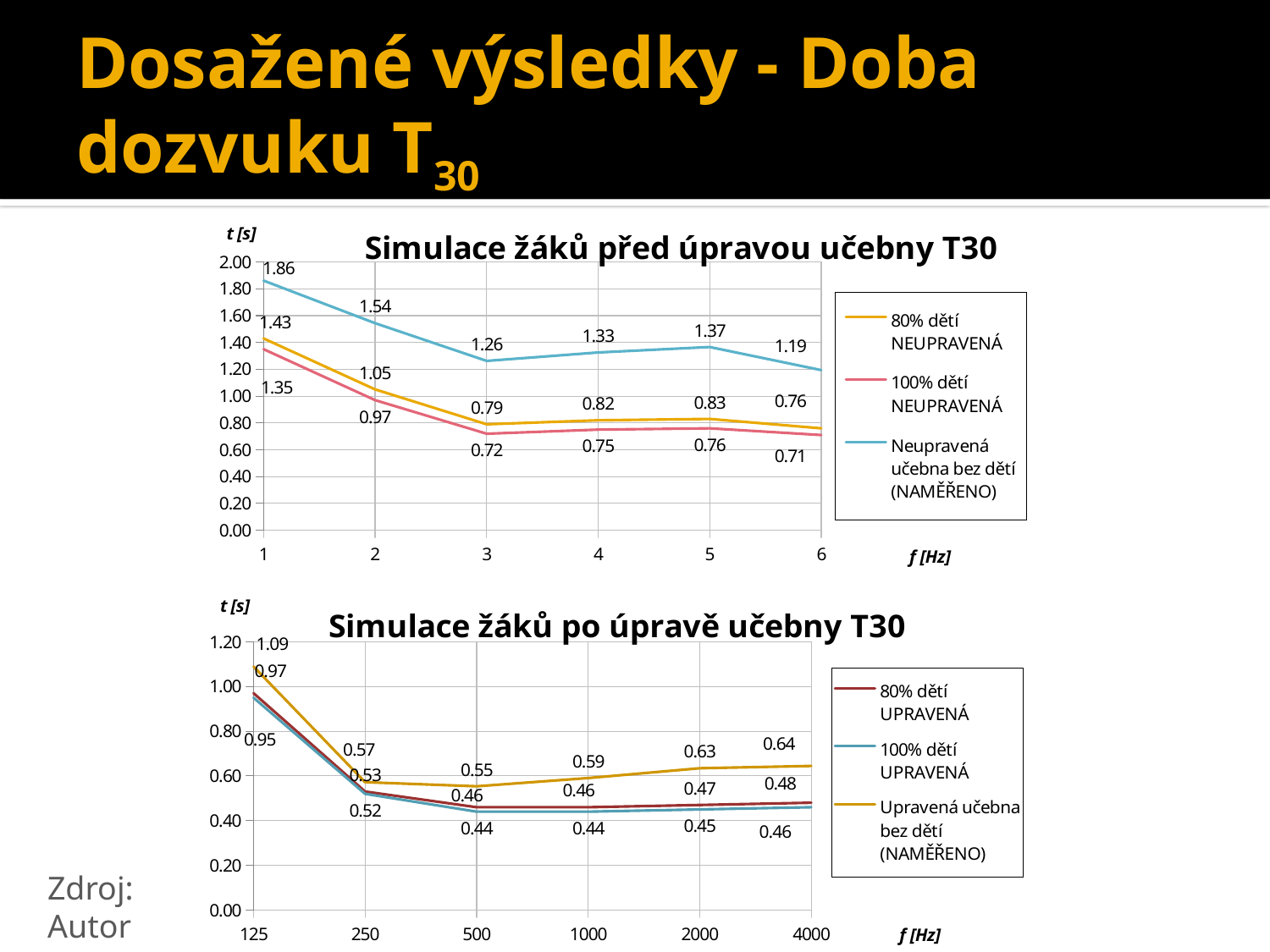
What kind of chart is the top chart titled "Simulace žáků před úpravou učebny T30"? line chart In the top chart "Simulace žáků před úpravou učebny T30", what is the value of the "100% dětí NEUPRAVENÁ" series at x = 6? 0.71 In the top chart "Simulace žáků před úpravou učebny T30", what is the value of the "Neupravená učebna bez dětí (NAMĚŘENO)" series at x = 1? 1.86 In the bottom chart "Simulace žáků po úpravě učebny T30", which series has the larger value at 2000 Hz: "80% dětí UPRAVENÁ" or "100% dětí UPRAVENÁ"? 80% dětí UPRAVENÁ In the top chart "Simulace žáků před úpravou učebny T30", at which x value does the "Neupravená učebna bez dětí (NAMĚŘENO)" series reach its highest value? 1 In the bottom chart "Simulace žáků po úpravě učebny T30", at which frequency does the "Upravená učebna bez dětí (NAMĚŘENO)" series have its lowest value? 500 How many series does the legend of the top chart "Simulace žáků před úpravou učebny T30" list? 3 In the bottom chart "Simulace žáků po úpravě učebny T30", what is the difference between the "Upravená učebna bez dětí (NAMĚŘENO)" value and the "100% dětí UPRAVENÁ" value at 125 Hz? 0.14 How many x-axis categories are plotted in the top chart "Simulace žáků před úpravou učebny T30"? 6 In the bottom chart "Simulace žáků po úpravě učebny T30", does the "Upravená učebna bez dětí (NAMĚŘENO)" series rise or fall from 500 Hz to 4000 Hz? rise In the bottom chart "Simulace žáků po úpravě učebny T30", what is the value of the "Upravená učebna bez dětí (NAMĚŘENO)" series at 4000 Hz? 0.64 In the top chart "Simulace žáků před úpravou učebny T30", what is the difference between the "Neupravená učebna bez dětí (NAMĚŘENO)" value and the "80% dětí NEUPRAVENÁ" value at x = 2? 0.49